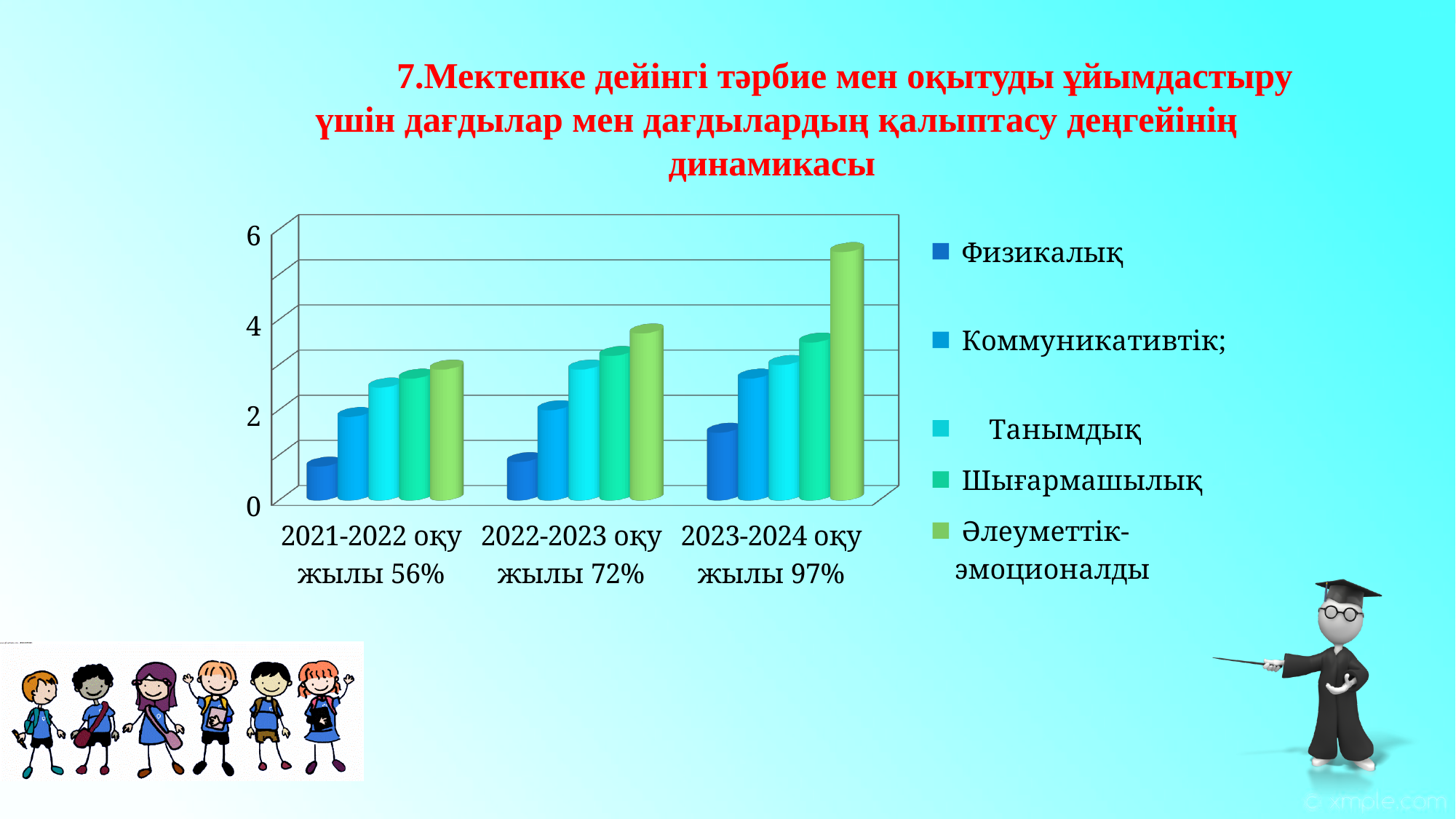
Is the value for Физикалық in 2021-2022 оқу жылы 56% greater or less than 2? less Which series has the shortest bar in the 2021-2022 оқу жылы 56% group? Физикалық Which is larger: the Әлеуметтік-эмоционалды value for 2021-2022 оқу жылы 56% or for 2023-2024 оқу жылы 97%? 2023-2024 оқу жылы 97% Which series has the tallest bar in the 2023-2024 оқу жылы 97% group? Әлеуметтік-эмоционалды Is the value for Танымдық in 2022-2023 оқу жылы 72% greater or less than 2? greater Is the value for Әлеуметтік-эмоционалды in 2023-2024 оқу жылы 97% greater or less than 4? greater How many academic-year categories are shown on the x axis? 3 How many series does the legend list? 5 Which series has the shortest bar in the 2023-2024 оқу жылы 97% group? Физикалық What kind of chart is shown on the slide? bar chart Does the Әлеуметтік-эмоционалды series rise or fall from 2021-2022 to 2023-2024? rise